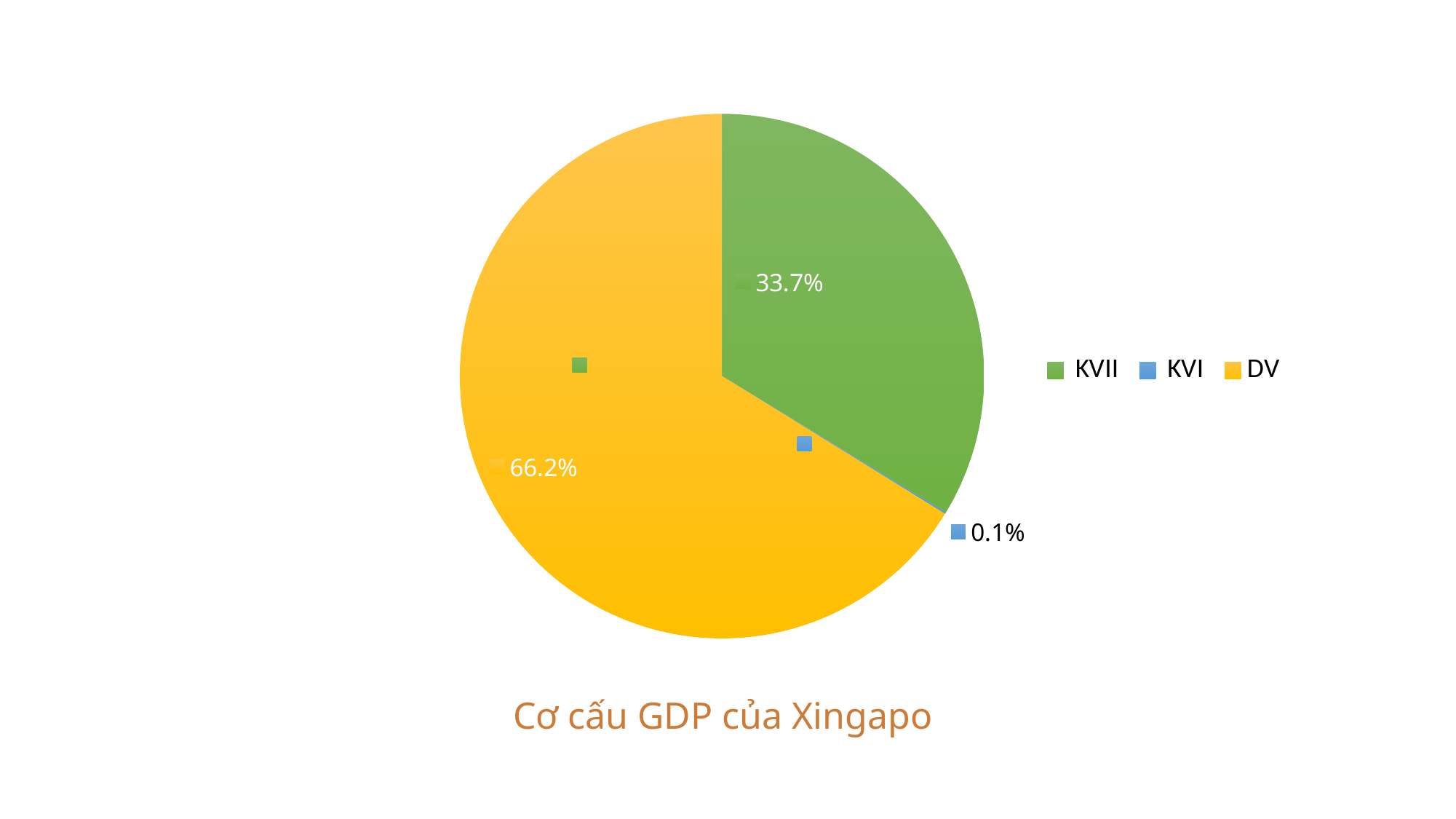
What percentage of GDP does KVI account for? 0.1% Which sector has the largest share of GDP? DV What colour represents KVI in the chart? blue What is the difference in percentage points between the DV share and the KVII share? 32.5 How many sectors are shown in the pie chart? 3 What is the difference in percentage points between the KVII share and the KVI share? 33.6 What percentage of GDP does DV account for? 66.2% What is the title of the chart? Cơ cấu GDP của Xingapo Which sector has the smallest share of GDP? KVI What percentage of GDP does KVII account for? 33.7% Which is larger, the share for KVII or the share for DV? DV What type of chart is shown on the slide? pie chart